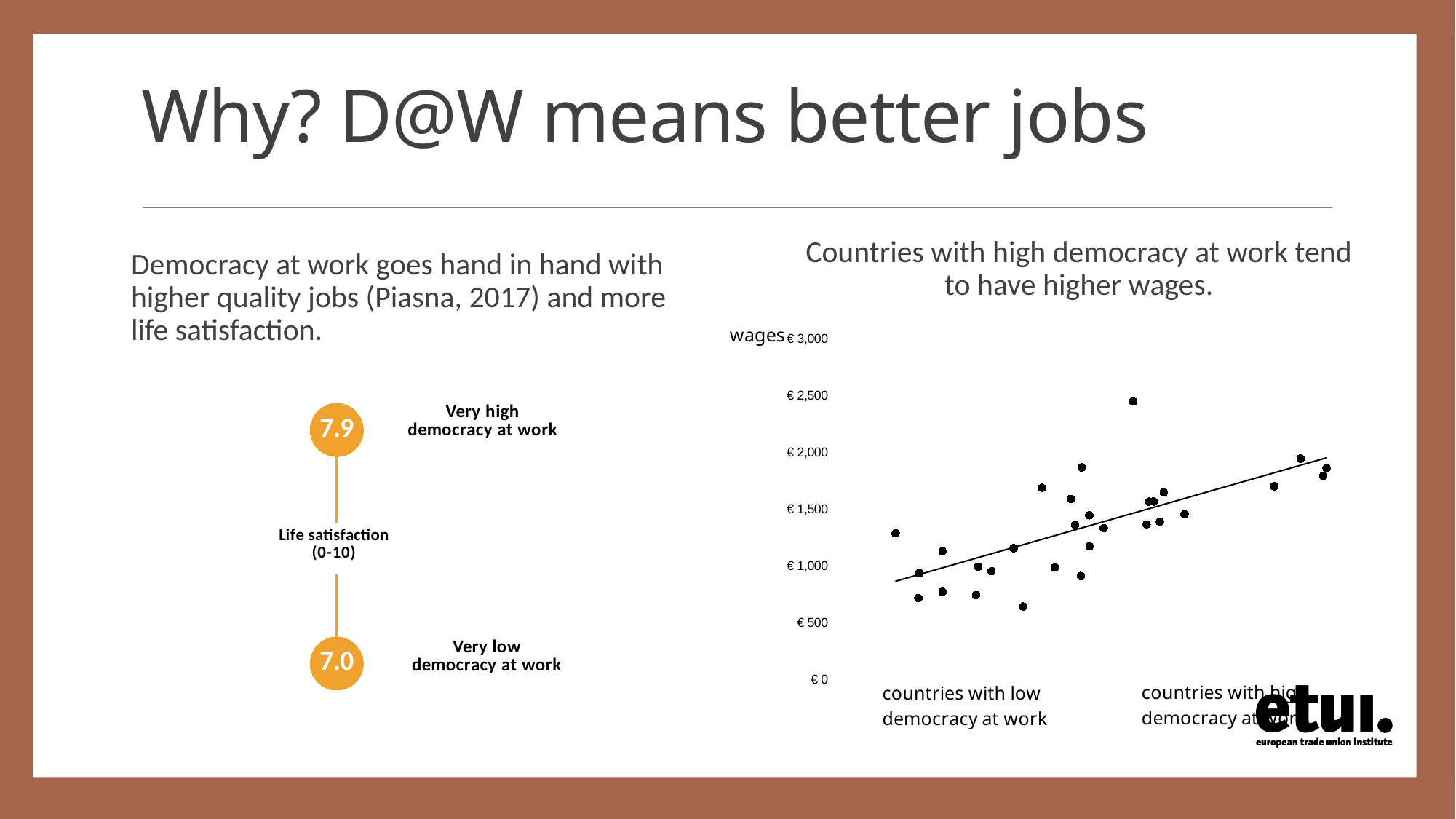
In the scatter chart on the right, what is the highest value shown on the wages axis? € 3,000 In the life satisfaction graphic on the left, what is the life satisfaction value for very low democracy at work? 7.0 In the life satisfaction graphic on the left, what is the life satisfaction value for very high democracy at work? 7.9 In the life satisfaction graphic on the left, what is the difference in life satisfaction between very high and very low democracy at work? 0.9 In the scatter chart on the right, what label is given to the vertical axis? wages In the scatter chart on the right, is the wage of the lowest plotted point greater or less than € 1,000? less In the life satisfaction graphic on the left, which has the higher life satisfaction value: very high democracy at work or very low democracy at work? Very high democracy at work In the scatter chart on the right, is the wage of the highest plotted point greater or less than € 2,000? greater In the scatter chart on the right, do wages tend to rise or fall as democracy at work increases from left to right? rise What kind of chart is shown on the right side of the slide under the heading 'Countries with high democracy at work tend to have higher wages'? scatter chart In the life satisfaction graphic on the left, how many values are shown? 2